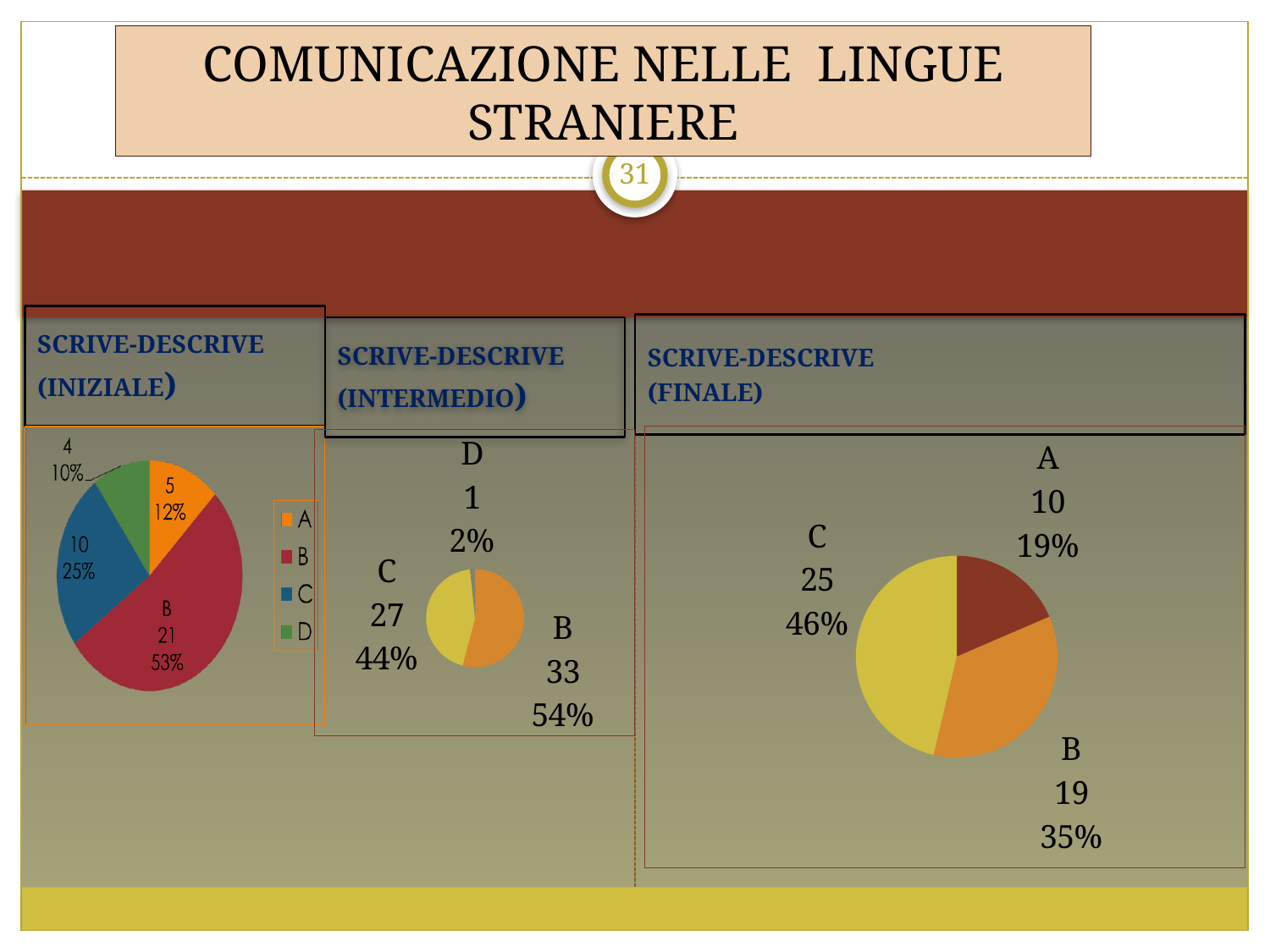
What kind of chart is the SCRIVE-DESCRIVE (INTERMEDIO) chart? pie chart How many categories does the legend of the SCRIVE-DESCRIVE (INIZIALE) chart list? 4 In the SCRIVE-DESCRIVE (INTERMEDIO) chart, which category has the largest slice? B How many slices does the SCRIVE-DESCRIVE (INTERMEDIO) pie chart have? 3 In the SCRIVE-DESCRIVE (FINALE) chart, which is larger, the value for A or the value for B? B In the SCRIVE-DESCRIVE (FINALE) chart, what is the difference between the values for C and A? 15 In the SCRIVE-DESCRIVE (FINALE) chart, what percentage share does C have? 46% In the SCRIVE-DESCRIVE (INIZIALE) chart, what percentage share does C have? 25% In the SCRIVE-DESCRIVE (INTERMEDIO) chart, what is the value for C? 27 In the SCRIVE-DESCRIVE (INIZIALE) chart, which category has the smallest slice? D In the SCRIVE-DESCRIVE (INTERMEDIO) chart, what is the difference between the values for B and C? 6 In the SCRIVE-DESCRIVE (INIZIALE) chart, what is the value for B? 21